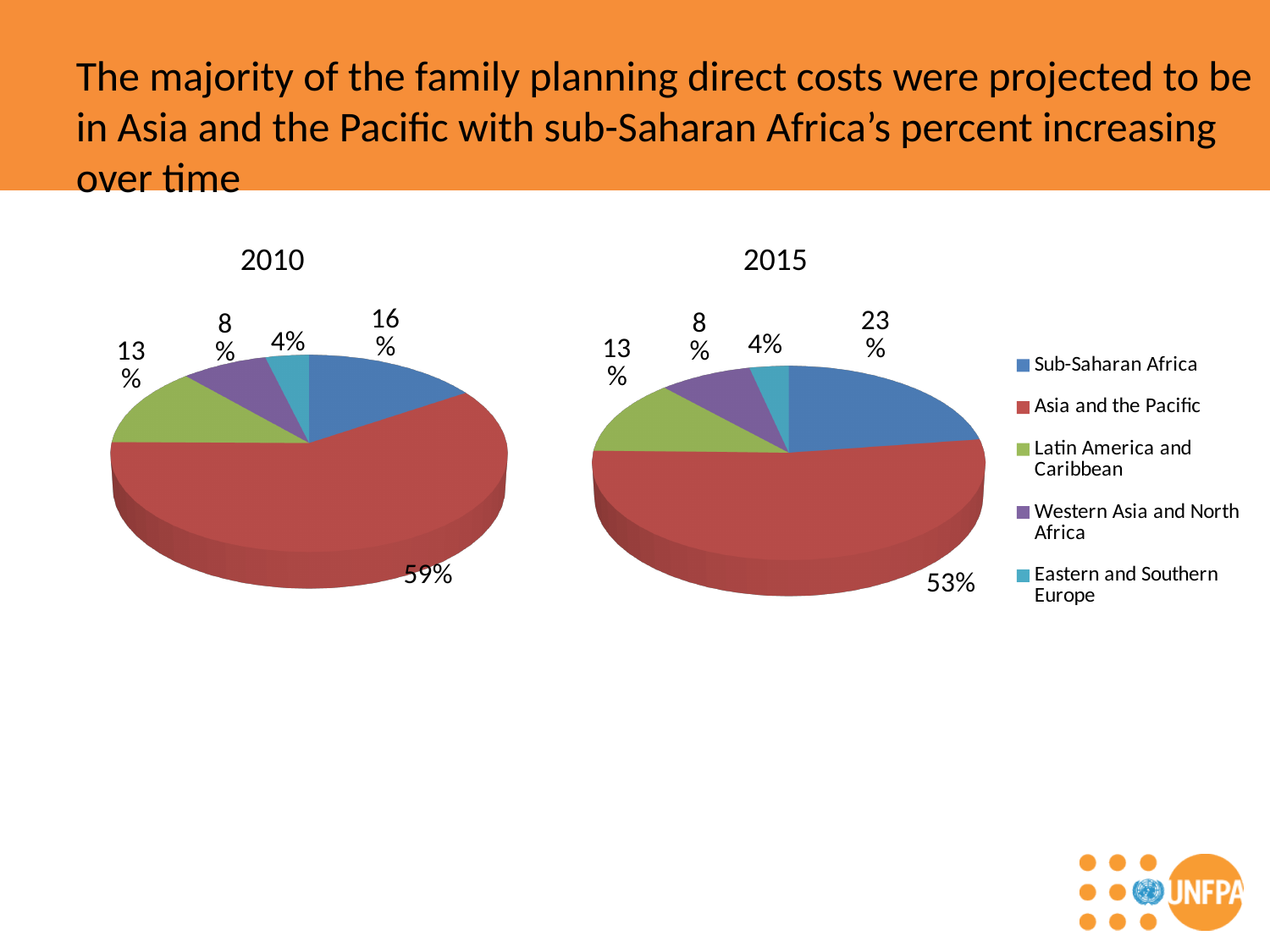
In the 2010 pie chart, which region has the largest share? Asia and the Pacific In the 2015 pie chart, what share is for Latin America and Caribbean? 13% In the 2010 pie chart, which is larger: the share for Latin America and Caribbean or the share for Western Asia and North Africa? Latin America and Caribbean Which region is shown in red in the legend? Asia and the Pacific How many slices does the 2015 pie chart have? 5 In the 2015 pie chart, what share is for Asia and the Pacific? 53% By how many percentage points did Sub-Saharan Africa's share increase from the 2010 chart to the 2015 chart? 7 In the 2015 pie chart, which region has the smallest share? Eastern and Southern Europe In the 2015 pie chart, what share is for Sub-Saharan Africa? 23% In the 2010 pie chart, what share of family planning direct costs is for Sub-Saharan Africa? 16% In the 2010 pie chart, what share is for Asia and the Pacific? 59% What type of chart is used to show the 2010 data? Pie chart